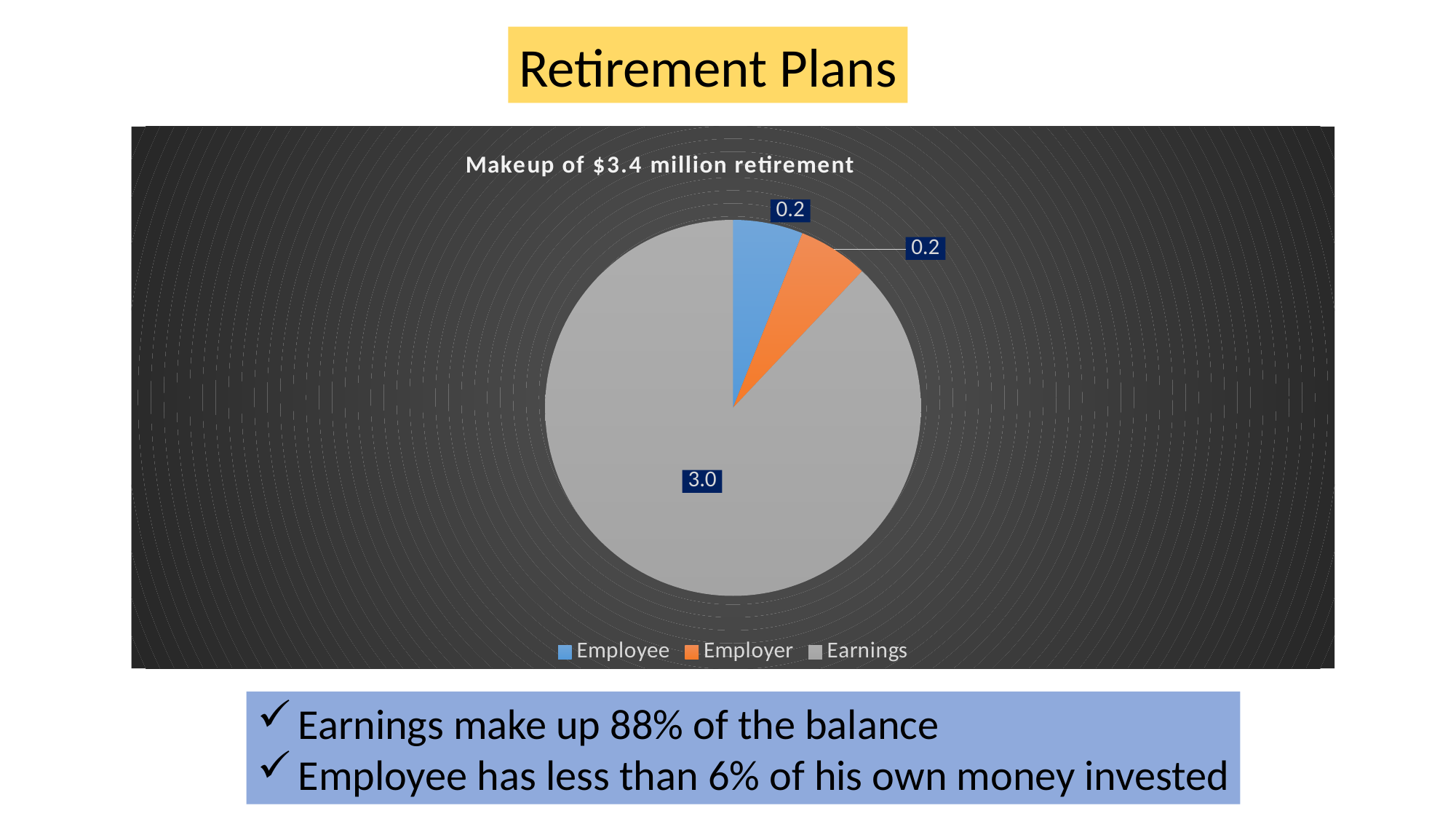
What is the value shown for Employer? 0.2 How many slices does the pie chart have? 3 Which is larger, the value for Earnings or the value for Employer? Earnings What is the difference between the values for Earnings and Employee? 2.8 What is the value shown for Earnings? 3.0 What is the total of all the slice values in the pie chart? 3.4 What type of chart is shown on the slide? Pie chart Which category has the largest slice of the pie? Earnings Are the values for Employee and Employer equal? Yes What is the title of the chart? Makeup of $3.4 million retirement What is the value shown for Employee? 0.2 How many entries does the legend list? 3